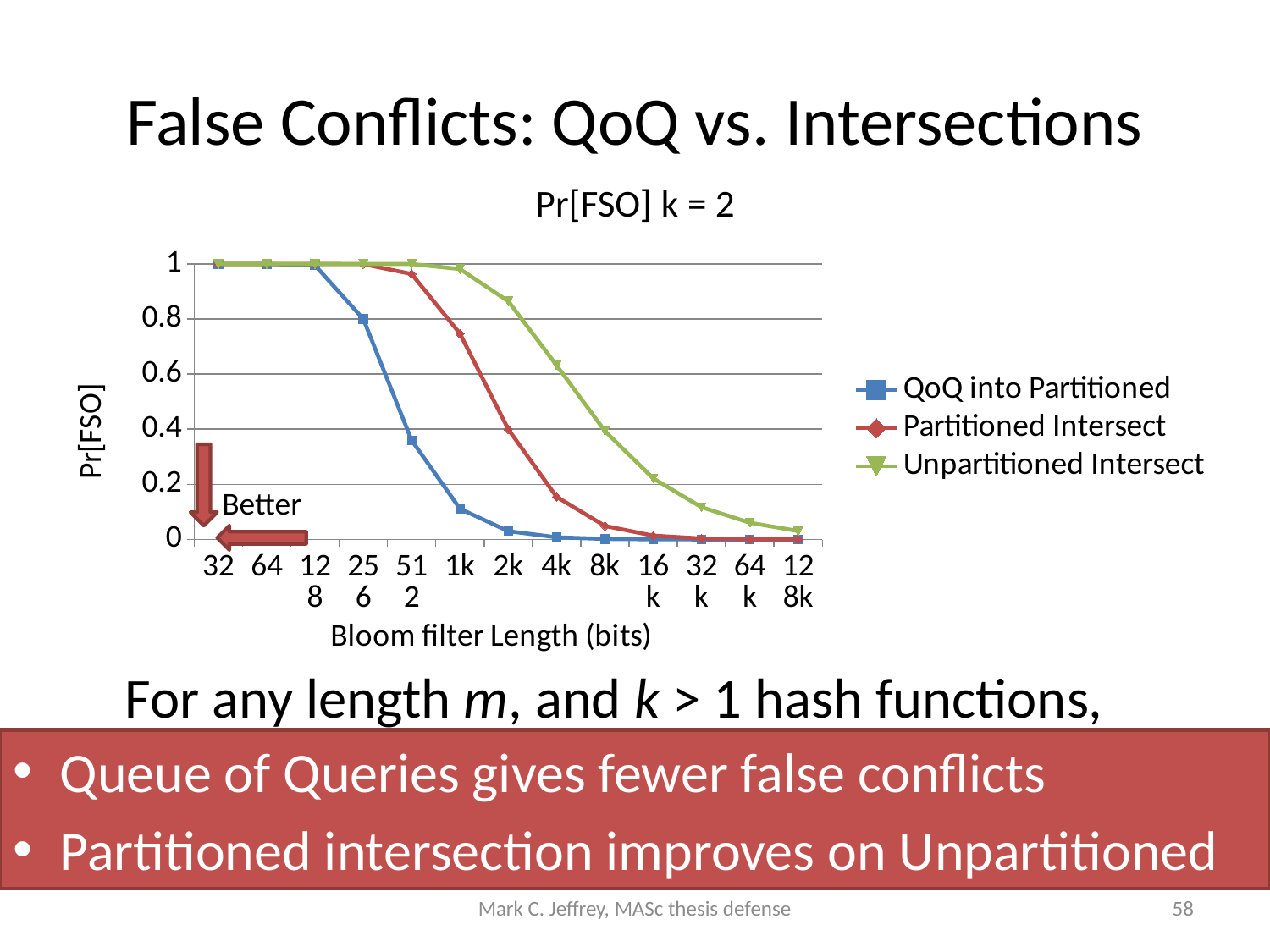
Is the value for Partitioned Intersect at 1k greater or less than 0.8? less How many Bloom filter lengths are plotted along the x axis? 13 At a Bloom filter length of 8k, which series has the highest Pr[FSO]? Unpartitioned Intersect What kind of chart is shown on the slide? line chart What is the label of the x axis? Bloom filter Length (bits) Is the value for Unpartitioned Intersect at 2k greater or less than 0.8? greater Do the values for each series rise or fall as the Bloom filter length increases? fall Is the value for QoQ into Partitioned at 1k greater or less than 0.2? less What is the title of the chart? Pr[FSO] k = 2 How many series does the legend list? 3 At a Bloom filter length of 512, which series has the lowest Pr[FSO]? QoQ into Partitioned